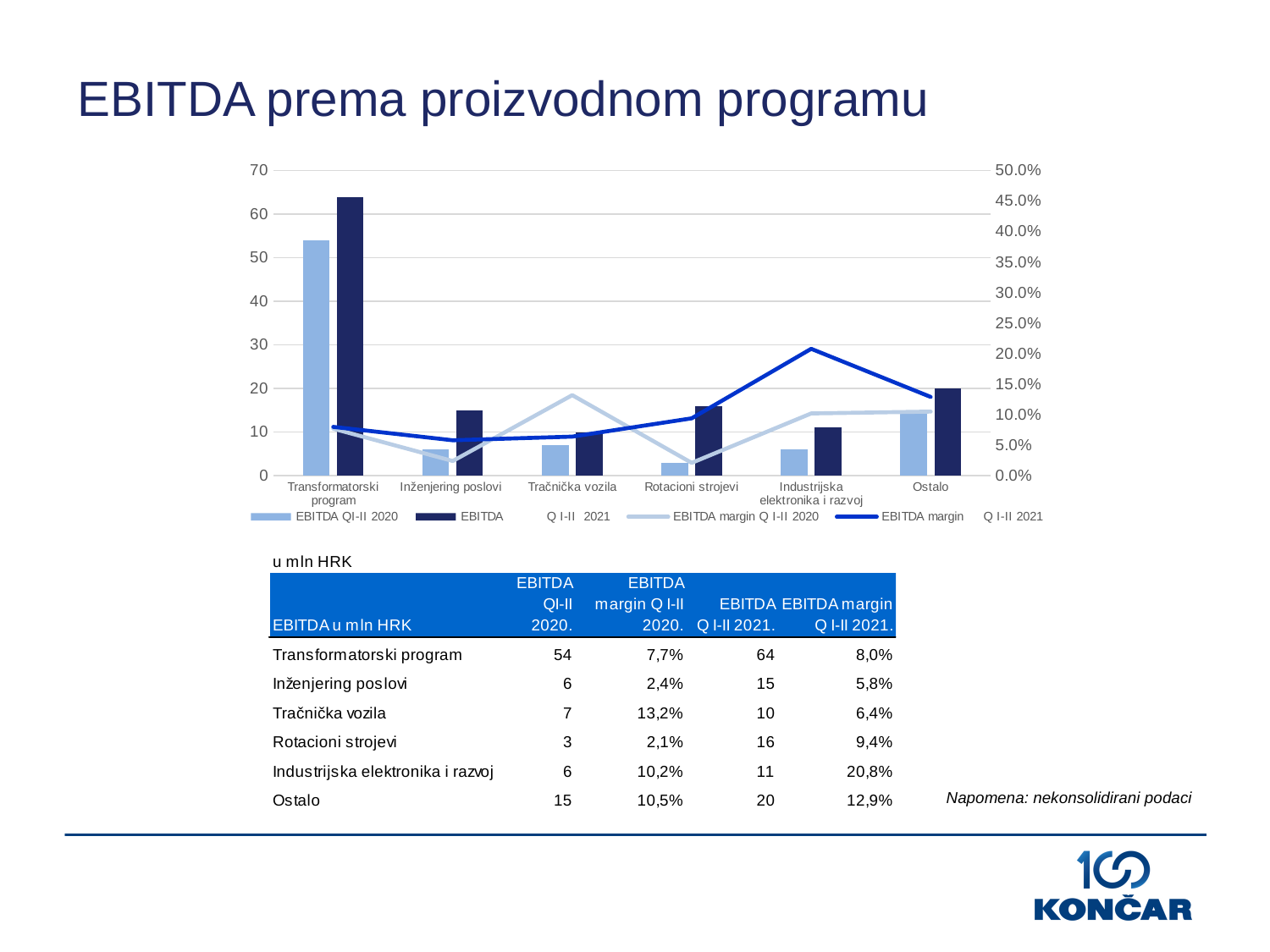
How many product programme categories are shown on the x axis of the chart? 6 How many series does the chart legend list? 4 What is the EBITDA QI-II 2020 value for Rotacioni strojevi? 3 Which category has the lowest EBITDA QI-II 2020? Rotacioni strojevi What type of chart is shown on the slide? Combined bar and line chart What is the title of the slide containing the chart? EBITDA prema proizvodnom programu What is the EBITDA margin Q I-II 2021 for Industrijska elektronika i razvoj? 20,8% What is the EBITDA Q I-II 2021 value for Transformatorski program? 64 What is the difference between EBITDA Q I-II 2021 and EBITDA QI-II 2020 for Transformatorski program? 10 Which is larger for Inženjering poslovi: EBITDA QI-II 2020 or EBITDA Q I-II 2021? EBITDA Q I-II 2021 Which category has the highest EBITDA Q I-II 2021? Transformatorski program Is the EBITDA Q I-II 2021 bar for Transformatorski program greater or less than 60? greater